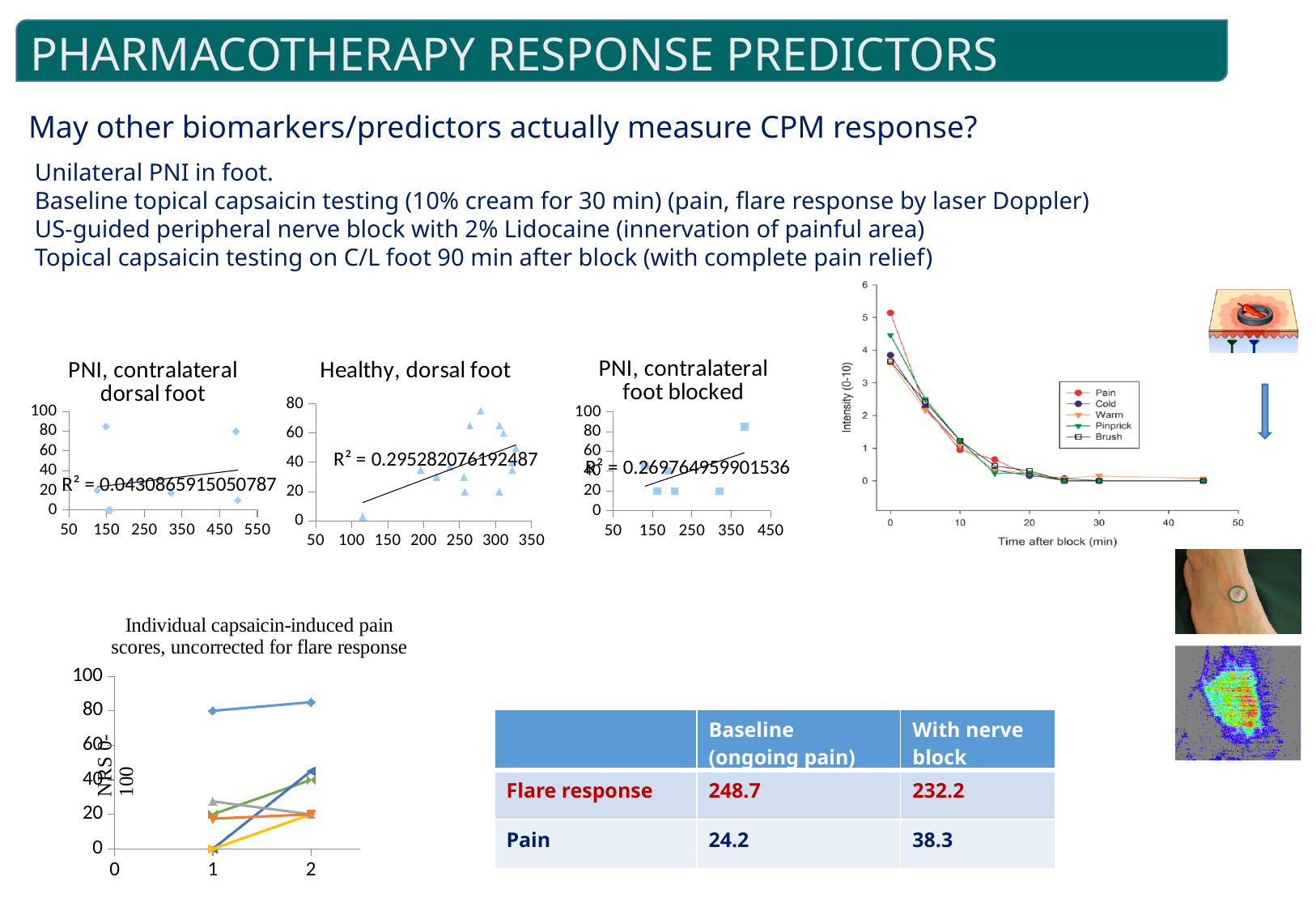
Among the three scatter charts (PNI contralateral dorsal foot, Healthy dorsal foot, PNI contralateral foot blocked), which has the highest R² value? Healthy, dorsal foot What are the legend entries in the chart with "Time after block (min)" on the x axis? Pain, Cold, Warm, Pinprick, Brush How many series does the legend list in the chart with "Time after block (min)" on the x axis? 5 What R² value is shown on the "PNI, contralateral foot blocked" chart? R² = 0.269764959901536 Among the three scatter charts, which has the lowest R² value? PNI, contralateral dorsal foot Is the R² of the "Healthy, dorsal foot" chart larger or smaller than the R² of the "PNI, contralateral foot blocked" chart? Larger In the chart with "Time after block (min)" on the x axis, is the Pain intensity at time 0 greater or less than 4? greater In the chart with "Time after block (min)" on the x axis, does the Pain series rise or fall as time increases? Fall What is the title of the line chart in the bottom-left of the slide? Individual capsaicin-induced pain scores, uncorrected for flare response What kind of chart is the "Healthy, dorsal foot" chart? Scatter chart What R² value is shown on the "Healthy, dorsal foot" chart? R² = 0.295282076192487 What R² value is shown on the "PNI, contralateral dorsal foot" chart? R² = 0.0430865915050787